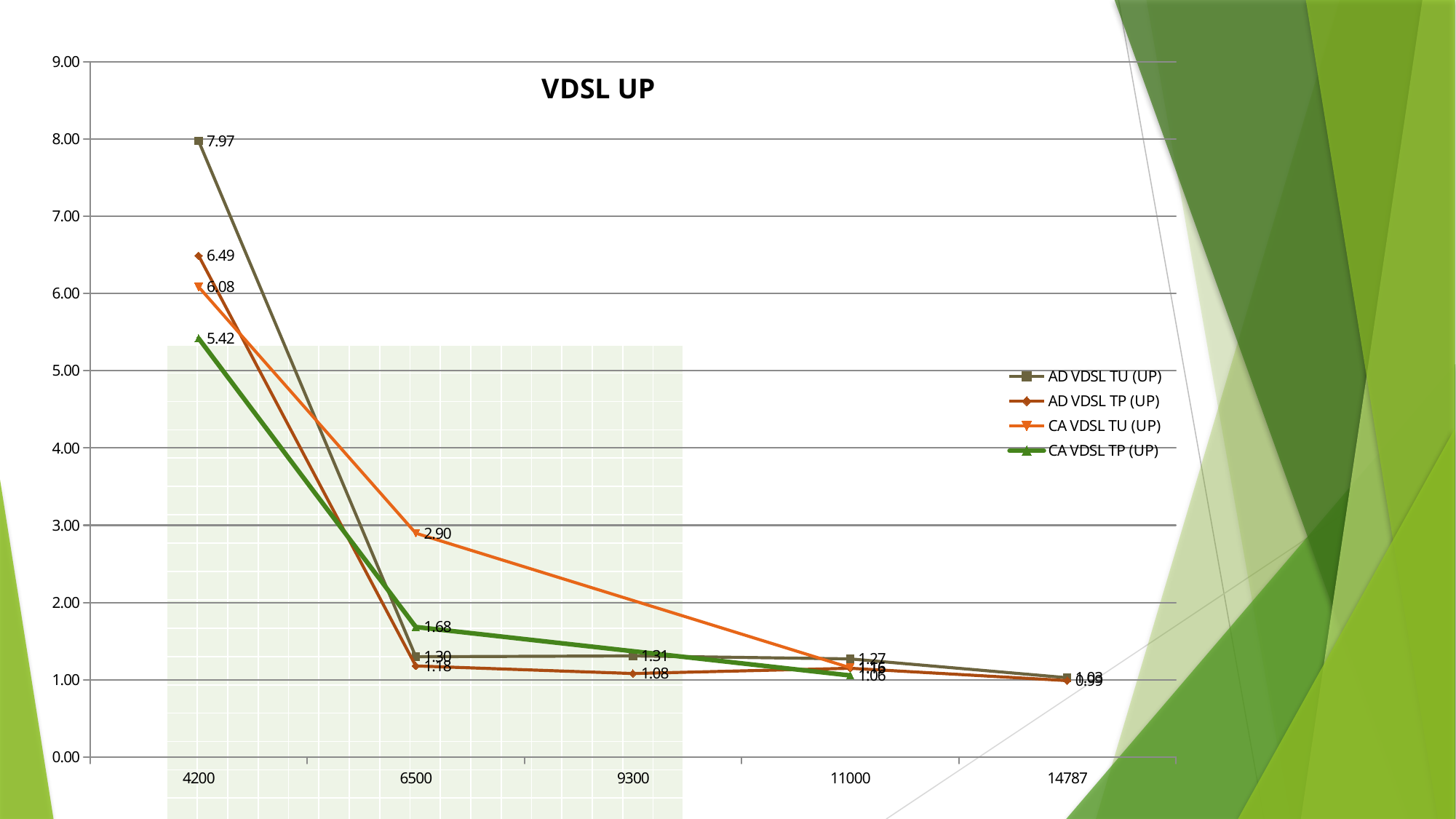
What is the title of the chart? VDSL UP What is the difference between AD VDSL TU (UP) and AD VDSL TP (UP) at 4200? 1.48 What is the value of AD VDSL TU (UP) at 4200? 7.97 What is the value of CA VDSL TP (UP) at 4200? 5.42 Do the values of AD VDSL TU (UP) generally rise or fall from 4200 to 14787? fall At 6500, which is larger: CA VDSL TU (UP) or CA VDSL TP (UP)? CA VDSL TU (UP) How many categories are shown on the x axis? 5 Which series has the lowest value at 4200? CA VDSL TP (UP) Which series has the highest value at 4200? AD VDSL TU (UP) How many series does the legend list? 4 What is the value of CA VDSL TU (UP) at 6500? 2.90 What type of chart is shown on the slide? line chart